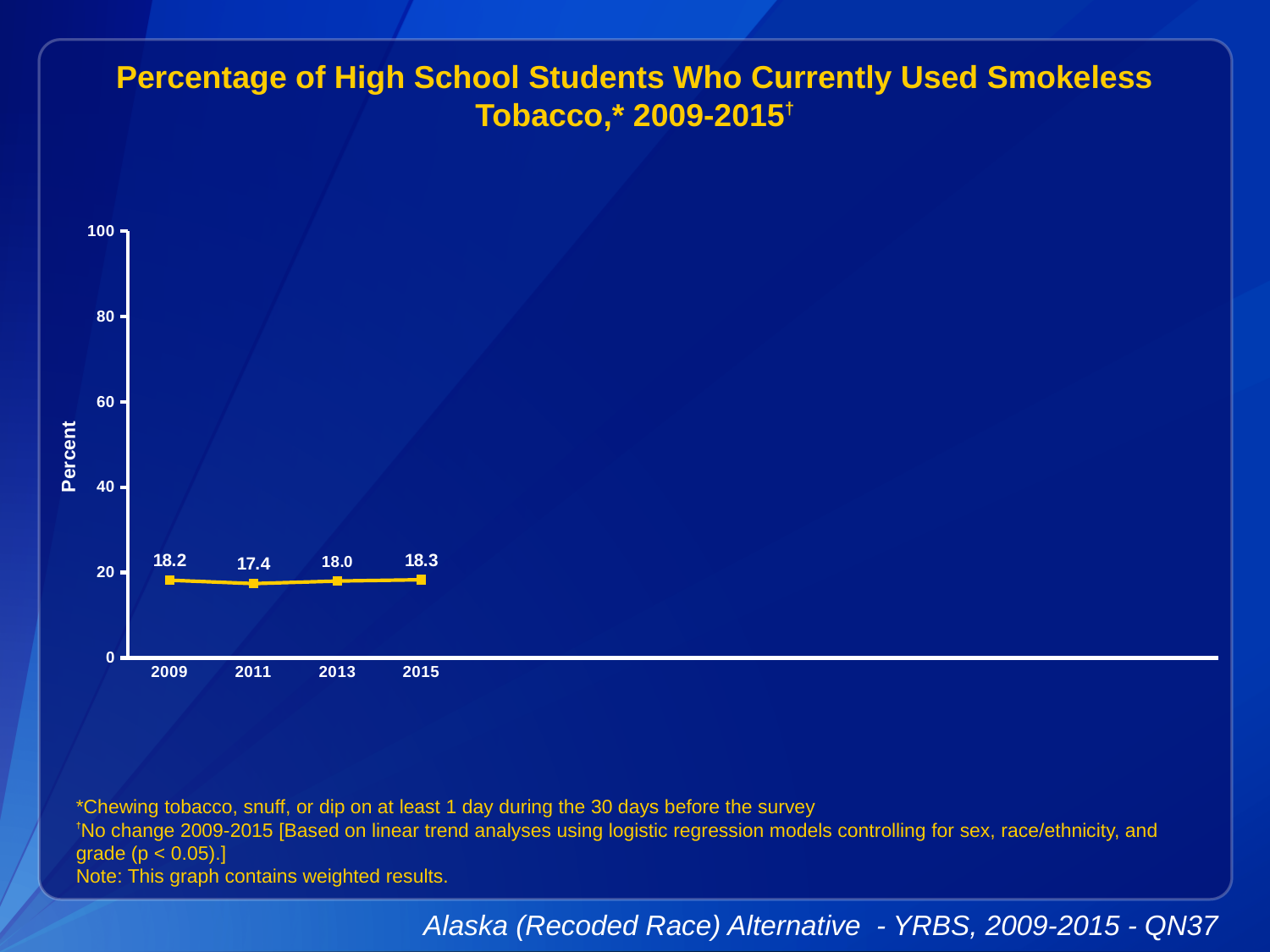
Is the value for 2013 greater or less than 20? less Which year has the lowest value? 2011 What is the difference between the values for 2015 and 2011? 0.9 What is the value for 2009? 18.2 What kind of chart is shown on the slide? line chart Which is larger, the value for 2009 or the value for 2011? 2009 Which year has the highest value? 2015 What is the label on the y axis? Percent What is the value for 2011? 17.4 How many years are plotted on the chart? 4 What is the value for 2015? 18.3 What is the value for 2013? 18.0